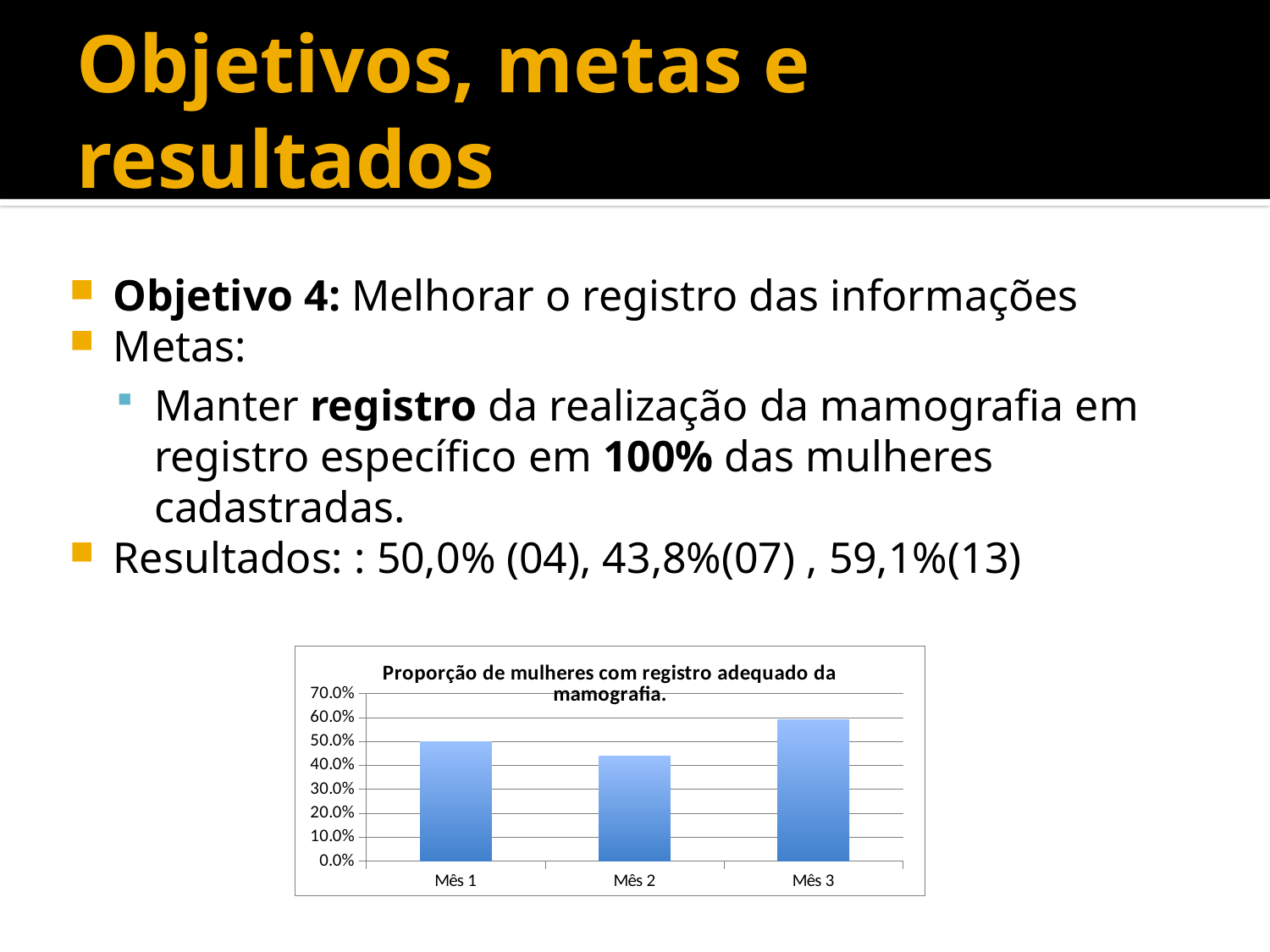
What is the value for Mês 1 in the chart? 50.0% What is the title of the chart? Proporção de mulheres com registro adequado da mamografia. How many categories are plotted on the x axis of the chart? 3 What kind of chart is shown on the slide? bar chart Is the value for Mês 2 greater or less than 40.0%? greater What is the highest value shown on the y axis of the chart? 70.0% Which is larger, the value for Mês 1 or the value for Mês 2? Mês 1 Which is larger, the value for Mês 3 or the value for Mês 1? Mês 3 Is the value for Mês 2 greater or less than 50.0%? less Which month has the lowest bar in the chart? Mês 2 Which month has the highest bar in the chart? Mês 3 Is the value for Mês 3 greater or less than 50.0%? greater